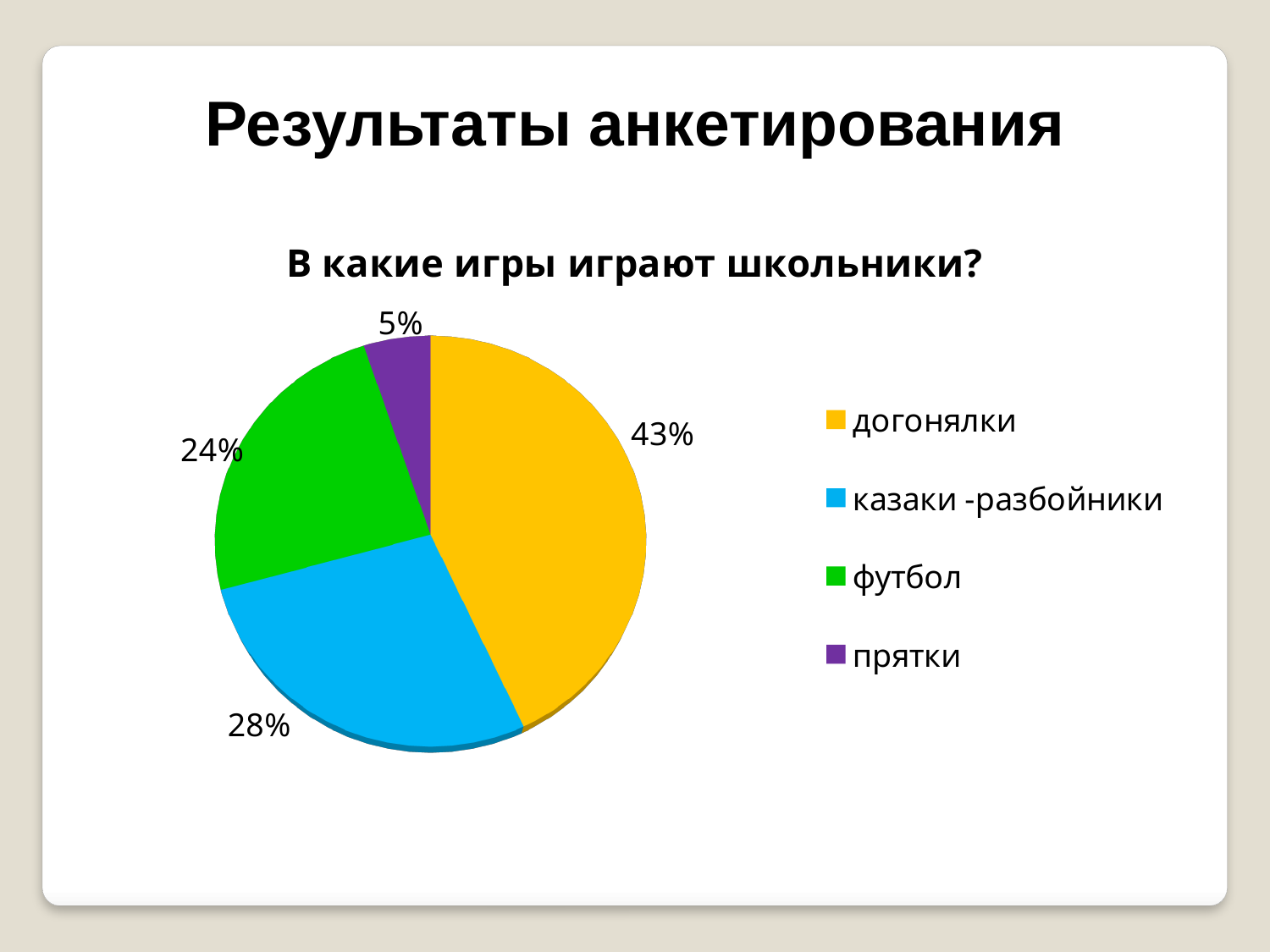
Which game has the smallest slice of the pie? прятки What share of the pie does футбол have? 24% How many categories does the pie chart show? 4 What is the difference in percentage points between казаки -разбойники and футбол? 4% What is the difference in percentage points between догонялки and прятки? 38% What share of the pie does догонялки have? 43% What is the chart's title? В какие игры играют школьники? What share of the pie does прятки have? 5% What kind of chart is shown on the slide? pie chart Which is larger, the share for футбол or the share for казаки -разбойники? казаки -разбойники Which game has the largest slice of the pie? догонялки